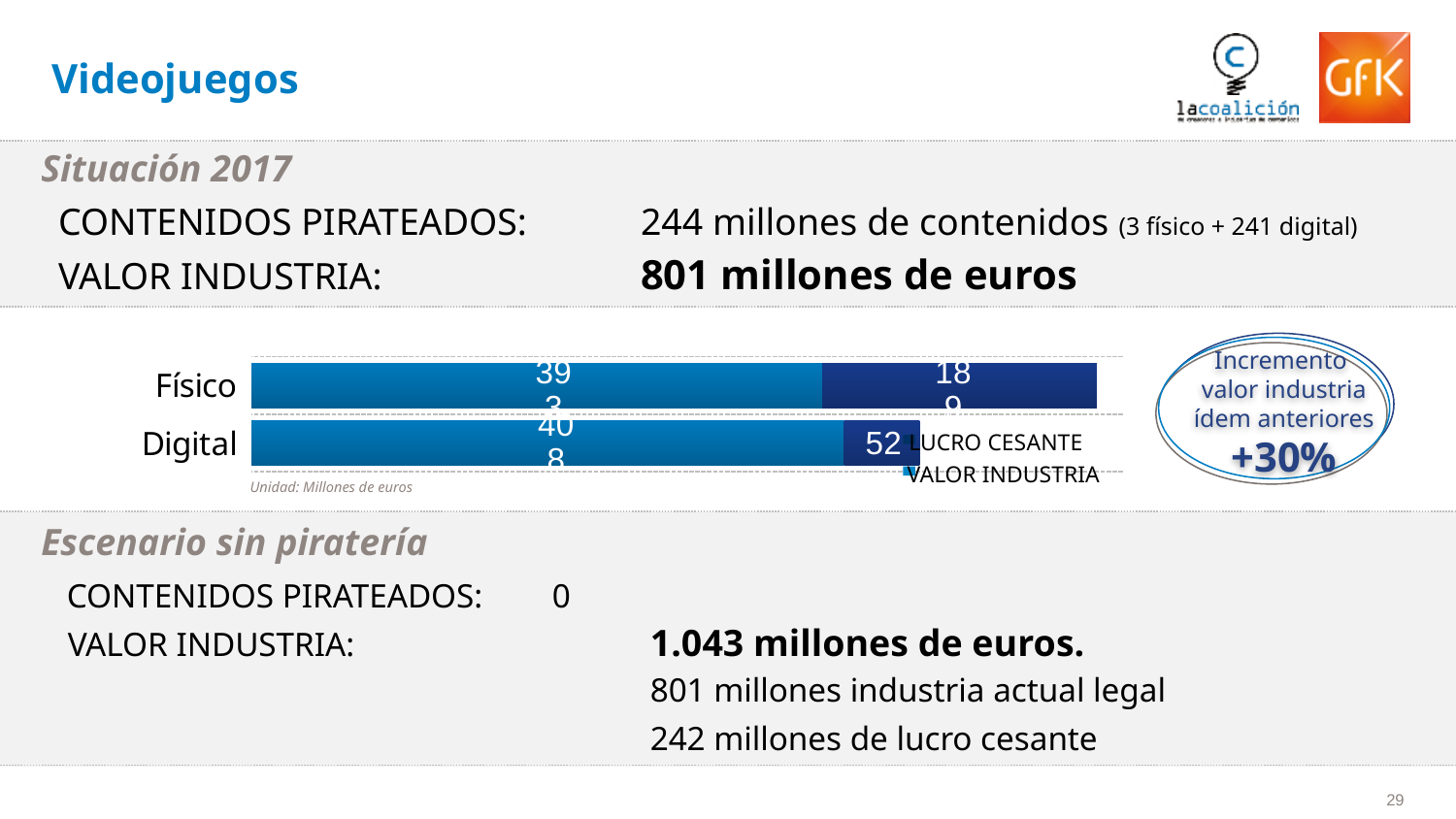
Which category has the shortest total stacked bar? Digital Which series is shown in dark blue in the bar chart? LUCRO CESANTE What unit does the note below the bar chart say the values are in? Millones de euros How many categories does the bar chart show? 2 What is the LUCRO CESANTE value for Digital in the bar chart? 52 What are the two categories shown on the bar chart? Físico and Digital What kind of chart is shown on the slide? Bar chart How many series does the chart legend list? 2 Which category has the longest total stacked bar? Físico Is the LUCRO CESANTE segment for Digital larger or smaller than the LUCRO CESANTE segment for Físico? Smaller Which category has the larger LUCRO CESANTE segment, Físico or Digital? Físico